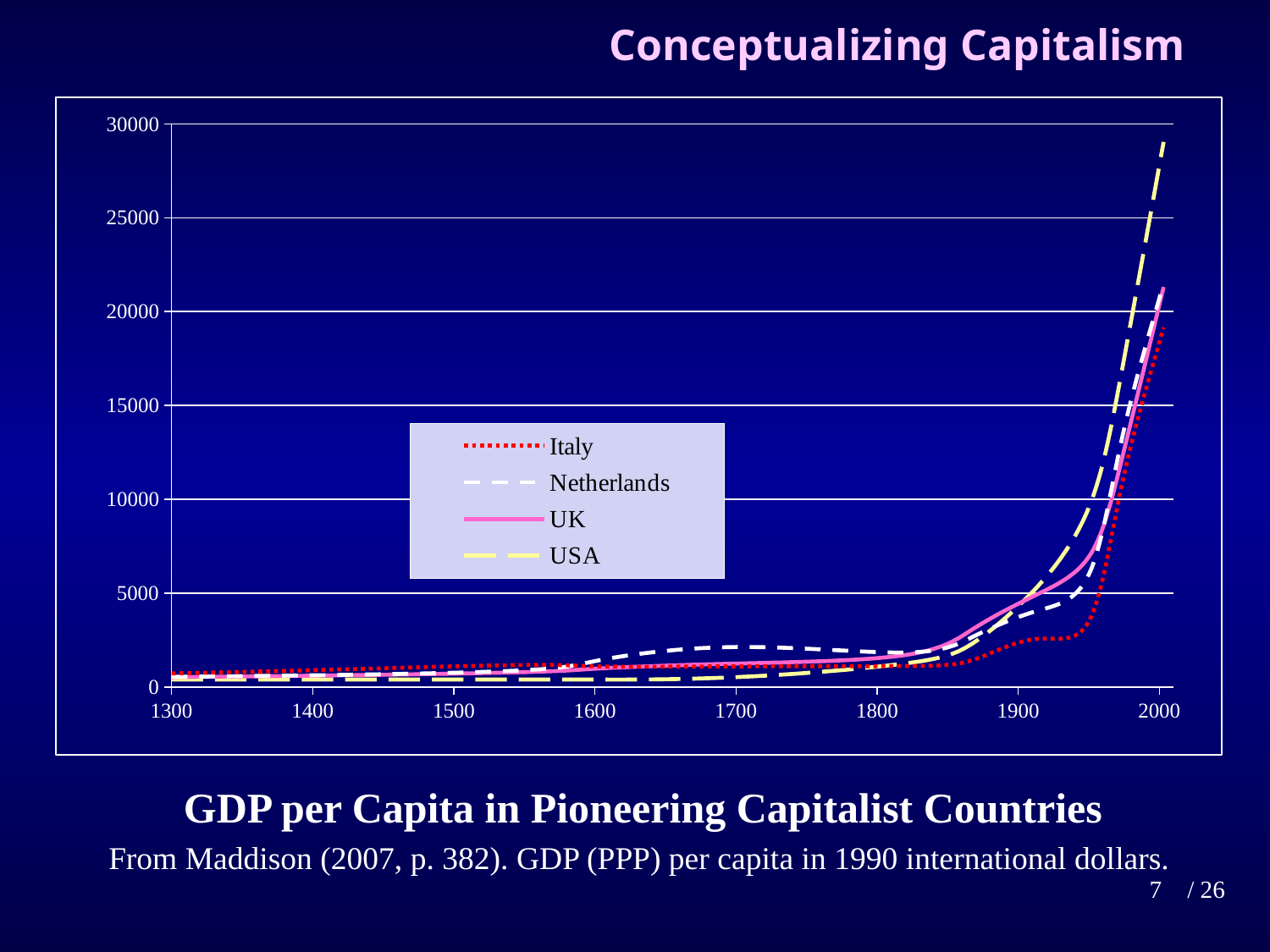
Is the value for Italy at 2000 greater or less than 20000? less Which country has the lowest GDP per capita at the year 2000? Italy Is the value for the Netherlands at 1700 greater or less than 5000? less Which countries are listed in the chart's legend? Italy, Netherlands, UK, USA Is the value for the USA at 2000 greater or less than 25000? greater Which country has the highest GDP per capita around the year 1700? Netherlands How many series does the legend list? 4 What kind of chart is shown on the slide? line chart Which country has the highest GDP per capita at the year 2000? USA Do the GDP per capita values generally rise or fall from 1300 to 2000? rise What is the title given below the chart? GDP per Capita in Pioneering Capitalist Countries